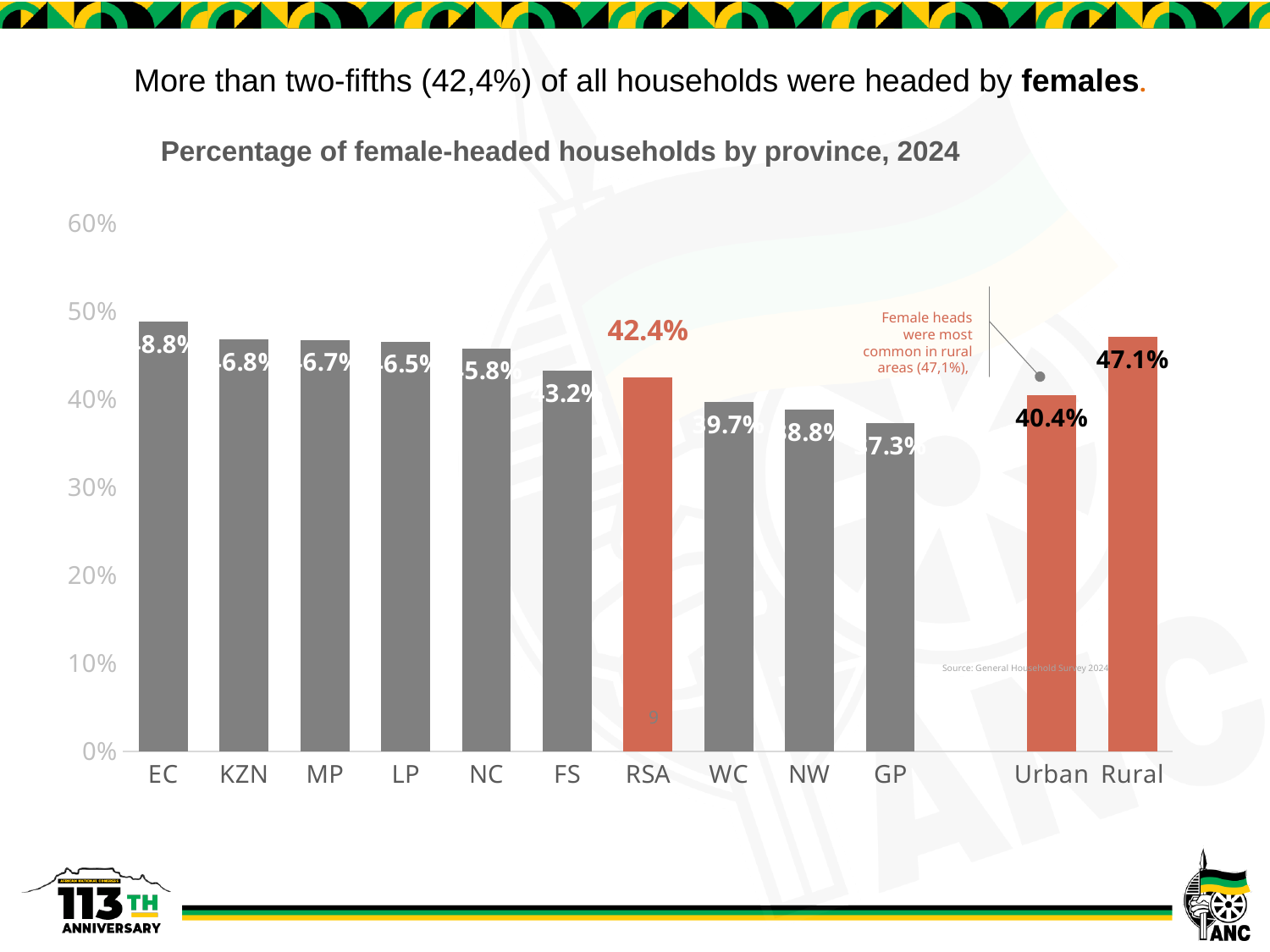
Which has a higher percentage of female-headed households, Urban or Rural? Rural What is the difference between the Rural and Urban percentages of female-headed households? 6.7 percentage points Which province has the highest percentage of female-headed households? EC What is the title of the chart? Percentage of female-headed households by province, 2024 Do the province values rise or fall moving from EC to GP along the x axis? fall Is the value for GP greater or less than 40%? less Is the value for KZN greater or less than 40%? greater What is the percentage of female-headed households in Rural areas? 47.1% What is the percentage of female-headed households for RSA? 42.4% How many bars are plotted in the chart? 12 What is the percentage of female-headed households in Urban areas? 40.4% What type of chart is shown on the slide? bar chart